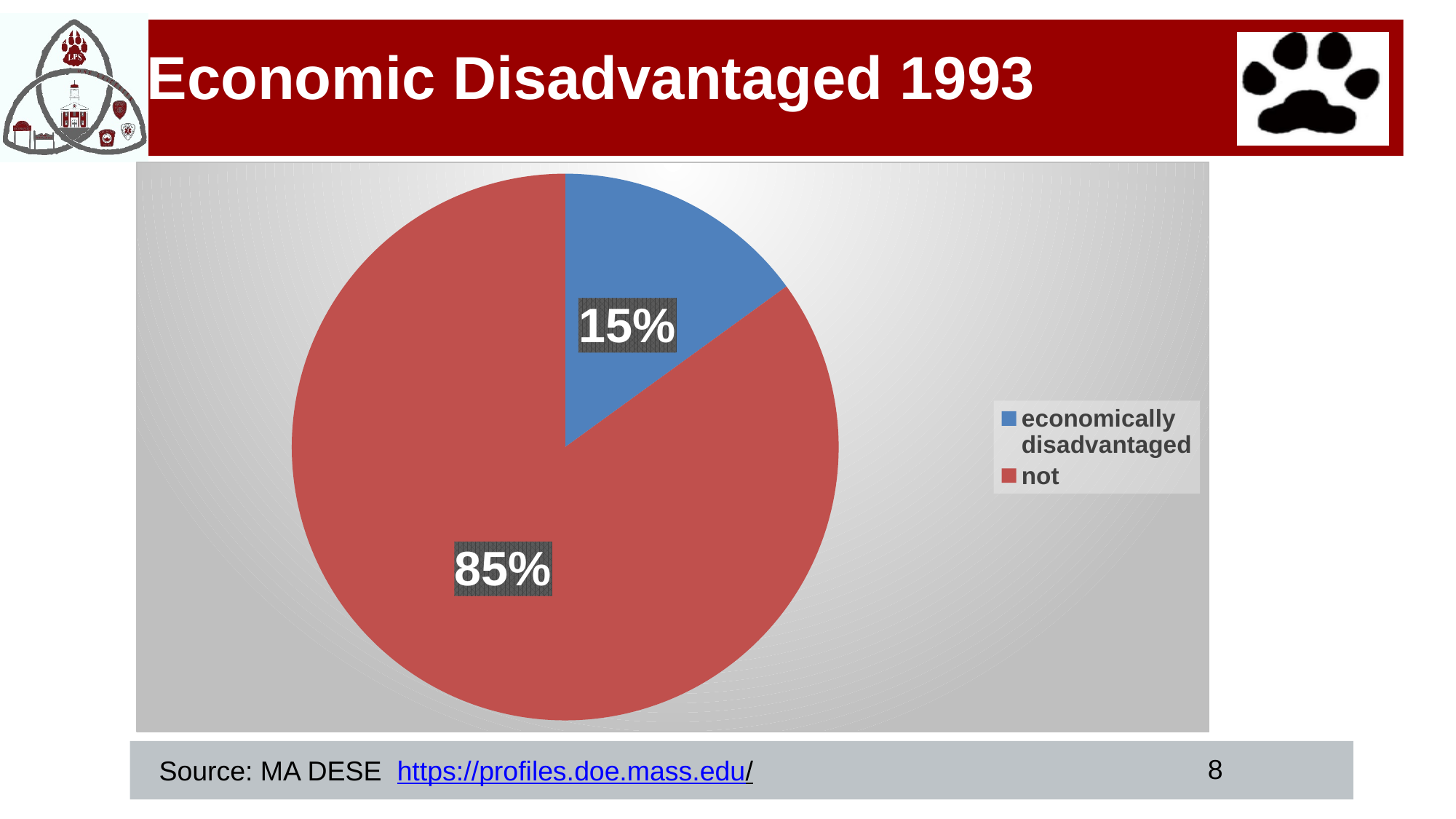
How many entries does the legend list? 2 What share of the pie is labelled "not"? 85% What colour is the "economically disadvantaged" slice? blue What is the title of the slide containing the pie chart? Economic Disadvantaged 1993 Which slice of the pie is the smallest? economically disadvantaged What kind of chart is shown on the slide? pie chart What share of the pie is labelled "economically disadvantaged"? 15% Which is larger, the "economically disadvantaged" slice or the "not" slice? not Which slice of the pie is the largest? not How many slices does the pie chart have? 2 What is the difference in percentage points between the "not" slice and the "economically disadvantaged" slice? 70